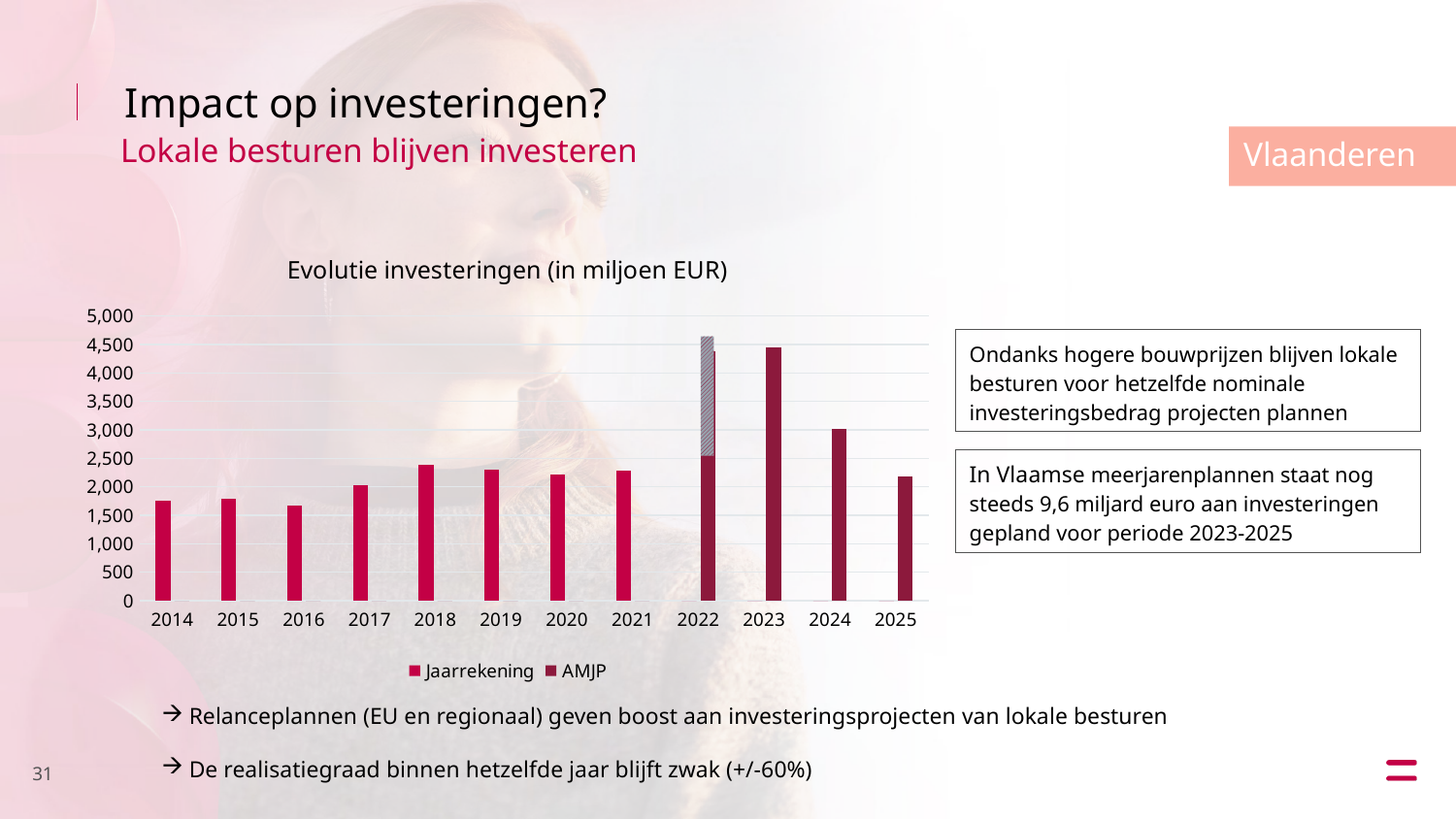
Is the value for 2014 greater or less than 2,000? less Is the value for 2024 greater or less than 2,500? greater Do the values rise or fall from 2023 to 2025? fall How many series does the chart legend list? 2 Is the value for 2023 greater or less than 4,000? greater How many years are shown on the x axis of the chart? 12 Which year has the larger value, 2024 or 2025? 2024 Which two series are listed in the chart legend? Jaarrekening and AMJP Which year has the larger value, 2018 or 2014? 2018 What is the title of the chart? Evolutie investeringen (in miljoen EUR) What kind of chart is shown on the slide? bar chart